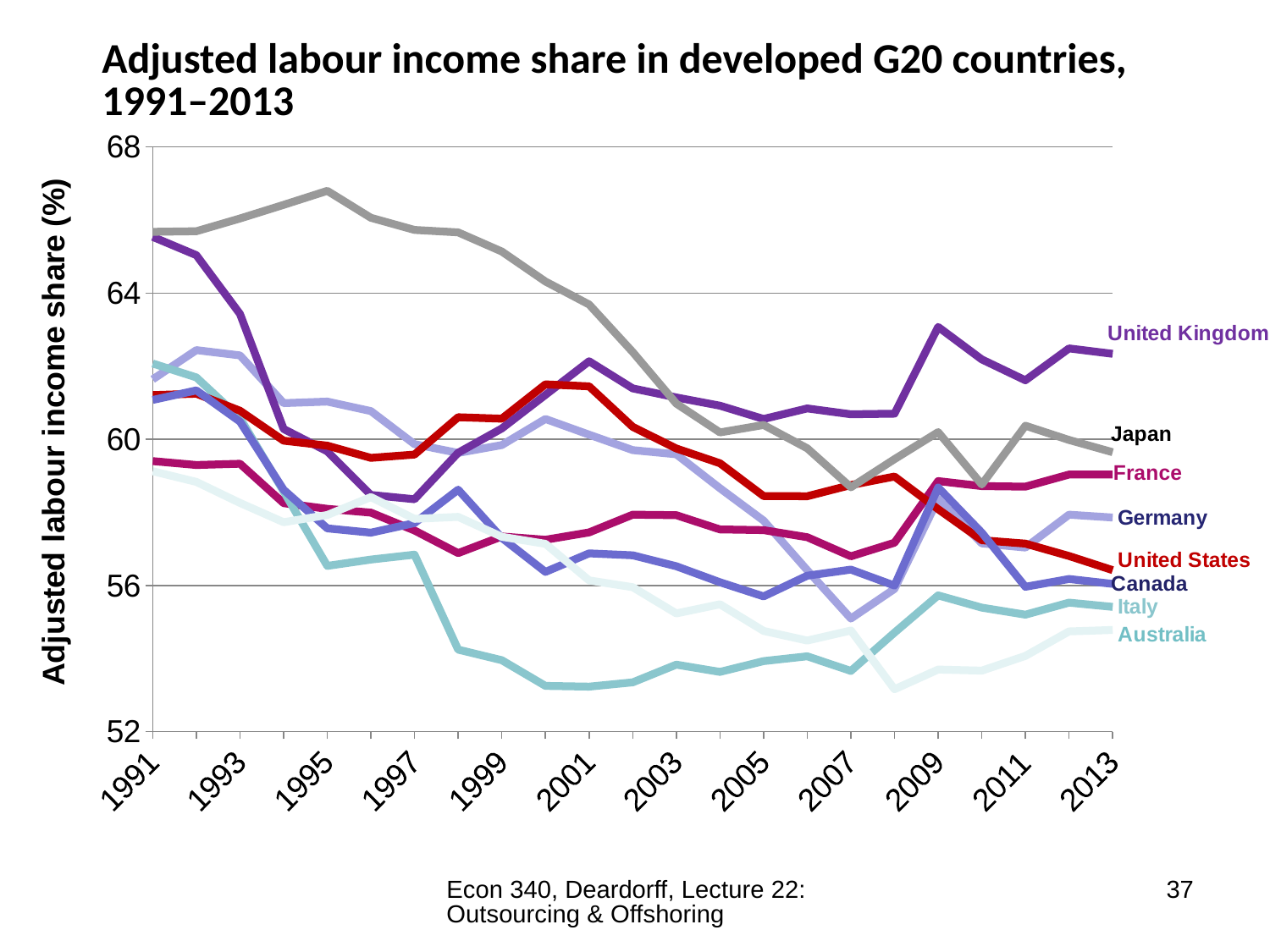
What is the title of the chart? Adjusted labour income share in developed G20 countries, 1991–2013 What kind of chart is shown on the slide? Line chart Which country had the highest adjusted labour income share in 1995? Japan In 2013, which is larger: the value for Japan or the value for the United Kingdom? United Kingdom Is the value for Japan in 1995 greater or less than 64? greater How many countries (series) are plotted on the chart? 8 Is the value for the United Kingdom in 2013 greater or less than 60? greater Does Japan's adjusted labour income share rise or fall overall from 1991 to 2013? Fall Which country had the highest adjusted labour income share in 2013? United Kingdom What is the label on the vertical axis? Adjusted labour income share (%) Which country had the lowest adjusted labour income share in 2001? Italy